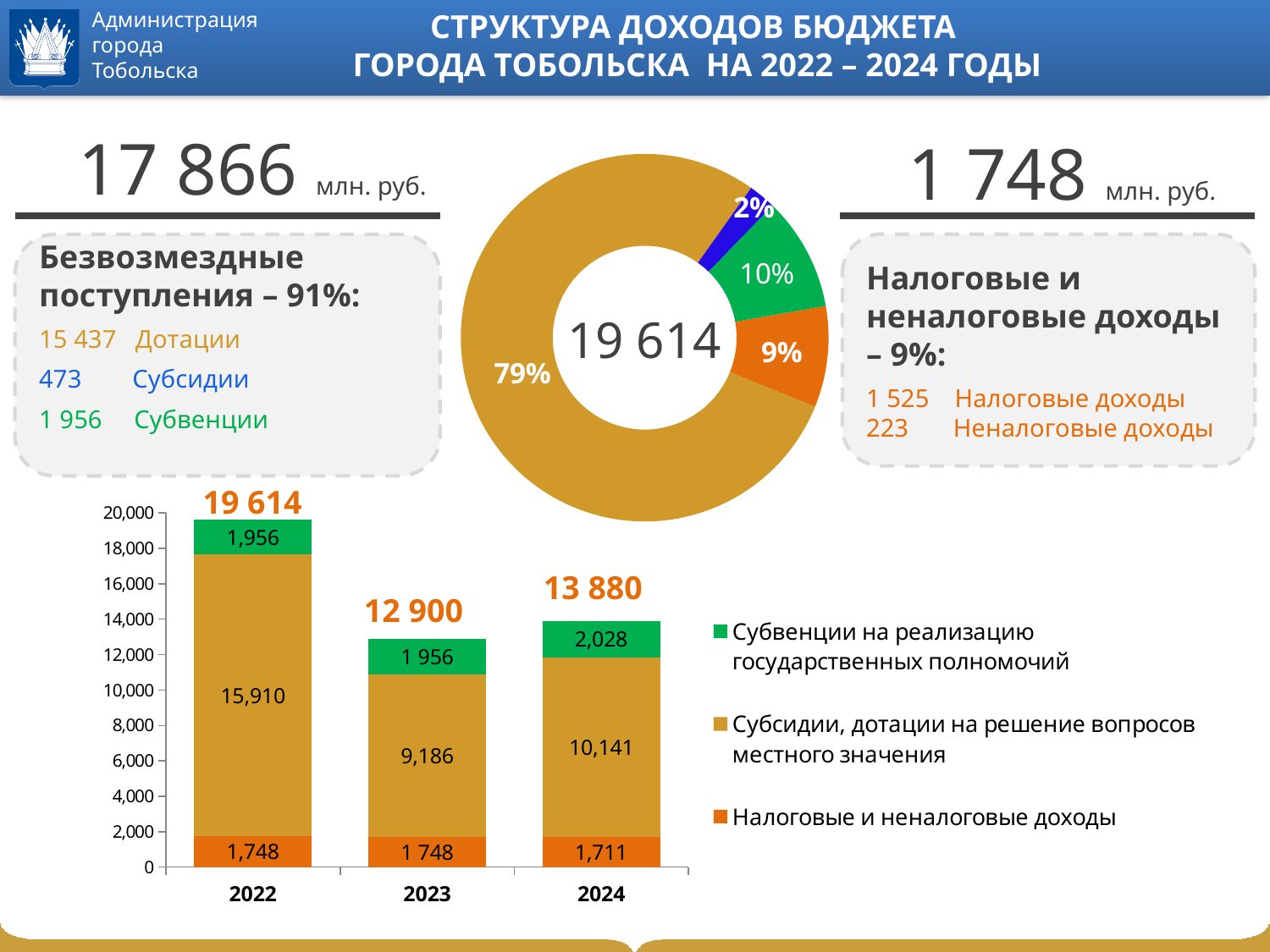
In the stacked bar chart at the bottom left, what is the value of the 'Субсидии, дотации на решение вопросов местного значения' segment for 2024? 10,141 In the stacked bar chart at the bottom left, what is the difference between the 'Субсидии, дотации' segment in 2022 and in 2023? 6,724 In the donut chart in the centre top of the slide, what share does the largest (gold) slice have? 79% How many series does the legend of the stacked bar chart at the bottom left list? 3 In the stacked bar chart at the bottom left, what is the total shown above the bar for 2022? 19 614 In the stacked bar chart at the bottom left, what is the value of the 'Субвенции на реализацию государственных полномочий' segment for 2024? 2,028 In the stacked bar chart at the bottom left, is the 'Субсидии, дотации' segment larger in 2024 or in 2023? 2024 In the stacked bar chart at the bottom left, what is the value of the 'Налоговые и неналоговые доходы' segment for 2023? 1 748 In the stacked bar chart at the bottom left, which year has the lowest total? 2023 What type of chart is the chart in the centre top of the slide showing 19 614? Donut chart How many years are shown on the x axis of the stacked bar chart at the bottom left? 3 In the stacked bar chart at the bottom left, which year has the highest total? 2022